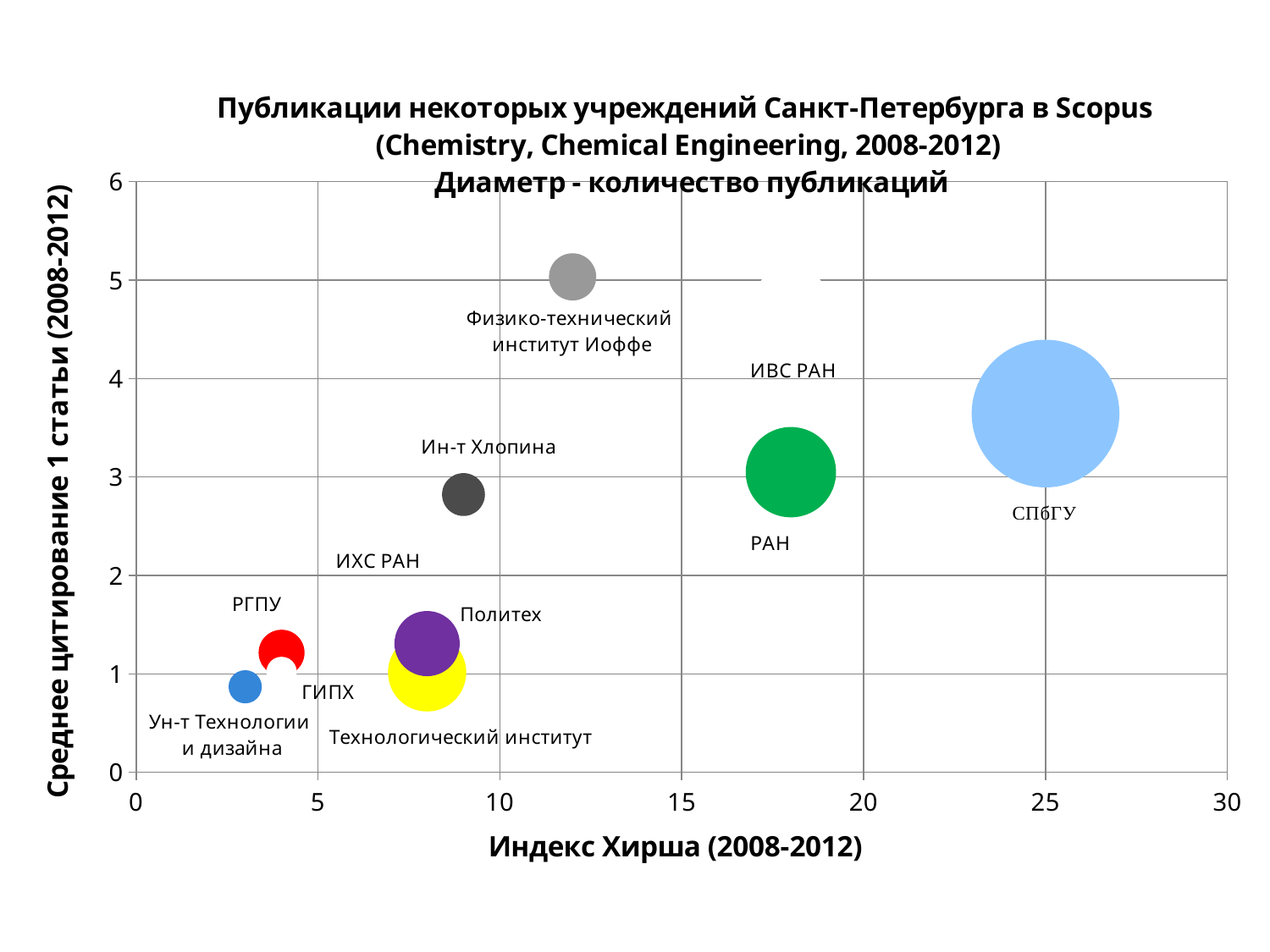
Which has the higher average citation per article, Физико-технический институт Иоффе or РАН? Физико-технический институт Иоффе Is the Hirsch index for Ун-т Технологии и дизайна greater or less than 5? less Which institution has the highest Hirsch index (furthest right on the x axis)? СПбГУ Is the Hirsch index for СПбГУ greater or less than 20? greater What is the title of the horizontal axis? Индекс Хирша (2008-2012) Is the average citation per article for Политех greater or less than 2? less Which institution has the largest bubble (most publications)? СПбГУ According to the chart title, what does the bubble diameter represent? Количество публикаций Which has the higher Hirsch index, СПбГУ or РАН? СПбГУ What kind of chart is shown on the slide? Bubble chart